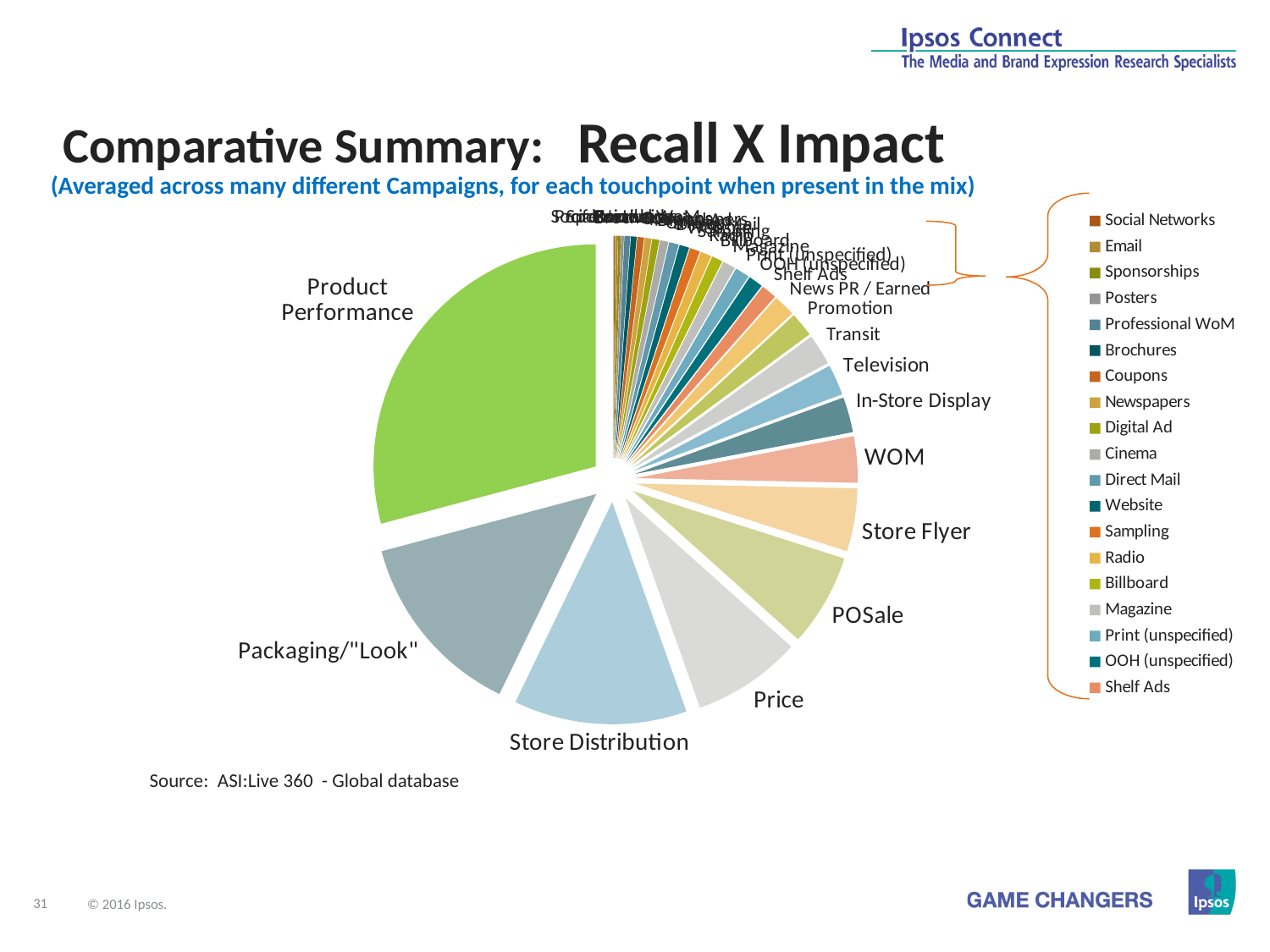
What is the title of the slide containing the chart? Comparative Summary: Recall X Impact What colour is the Product Performance slice? green Which category has the largest slice of the pie chart? Product Performance Which slice is larger, POSale or Television? POSale What kind of chart is shown on the slide? pie chart Which slice is larger, Price or In-Store Display? Price How many entries does the legend on the right of the chart list? 19 Which slice is larger, Packaging/"Look" or Store Flyer? Packaging/"Look"